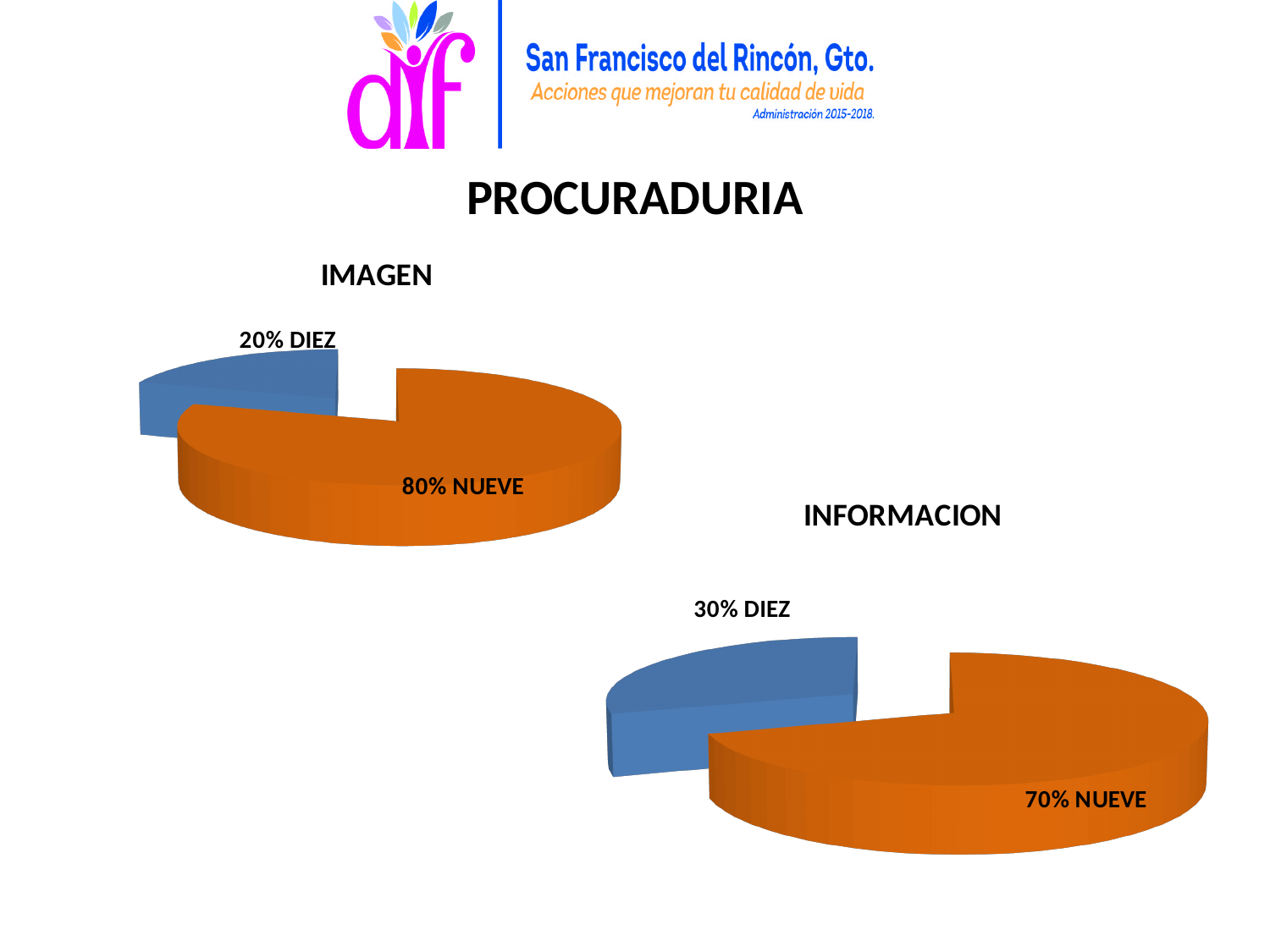
What kind of chart is the IMAGEN chart? Pie chart In the IMAGEN chart, what share does the DIEZ slice have? 20% In the IMAGEN chart, what share does the NUEVE slice have? 80% In the INFORMACION chart, which slice is the smallest? DIEZ How many slices does the INFORMACION chart have? 2 In the IMAGEN chart, which slice is the largest? NUEVE In the IMAGEN chart, what is the difference between the NUEVE and DIEZ shares? 60% In the INFORMACION chart, what share does the DIEZ slice have? 30% In the INFORMACION chart, what is the difference between the NUEVE and DIEZ shares? 40% What colour is the NUEVE slice in the INFORMACION chart? Orange Is the DIEZ share larger in the IMAGEN chart or the INFORMACION chart? INFORMACION